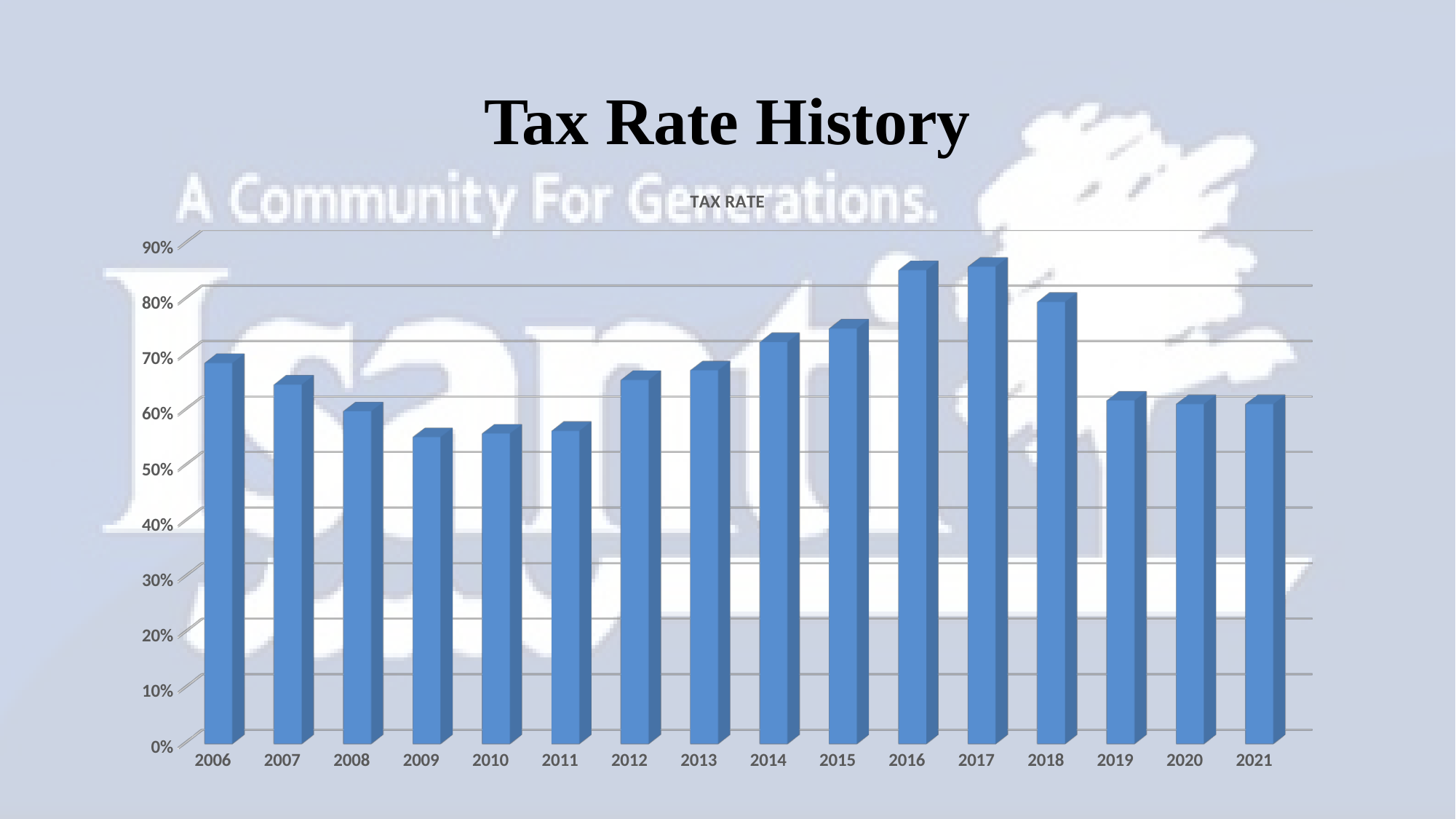
Is the value for 2018 greater or less than 70%? greater What is the title printed above the chart? TAX RATE Is the value for 2014 greater or less than 70%? greater Is the value for 2016 greater or less than 80%? greater Do the values rise or fall from 2011 to 2017? Rise How many years are plotted on the x axis of the chart? 16 Which year has the larger tax rate, 2016 or 2009? 2016 What is the highest value shown on the y axis of the chart? 90% Which year has the larger tax rate, 2006 or 2021? 2006 What kind of chart is shown on the slide? Bar chart